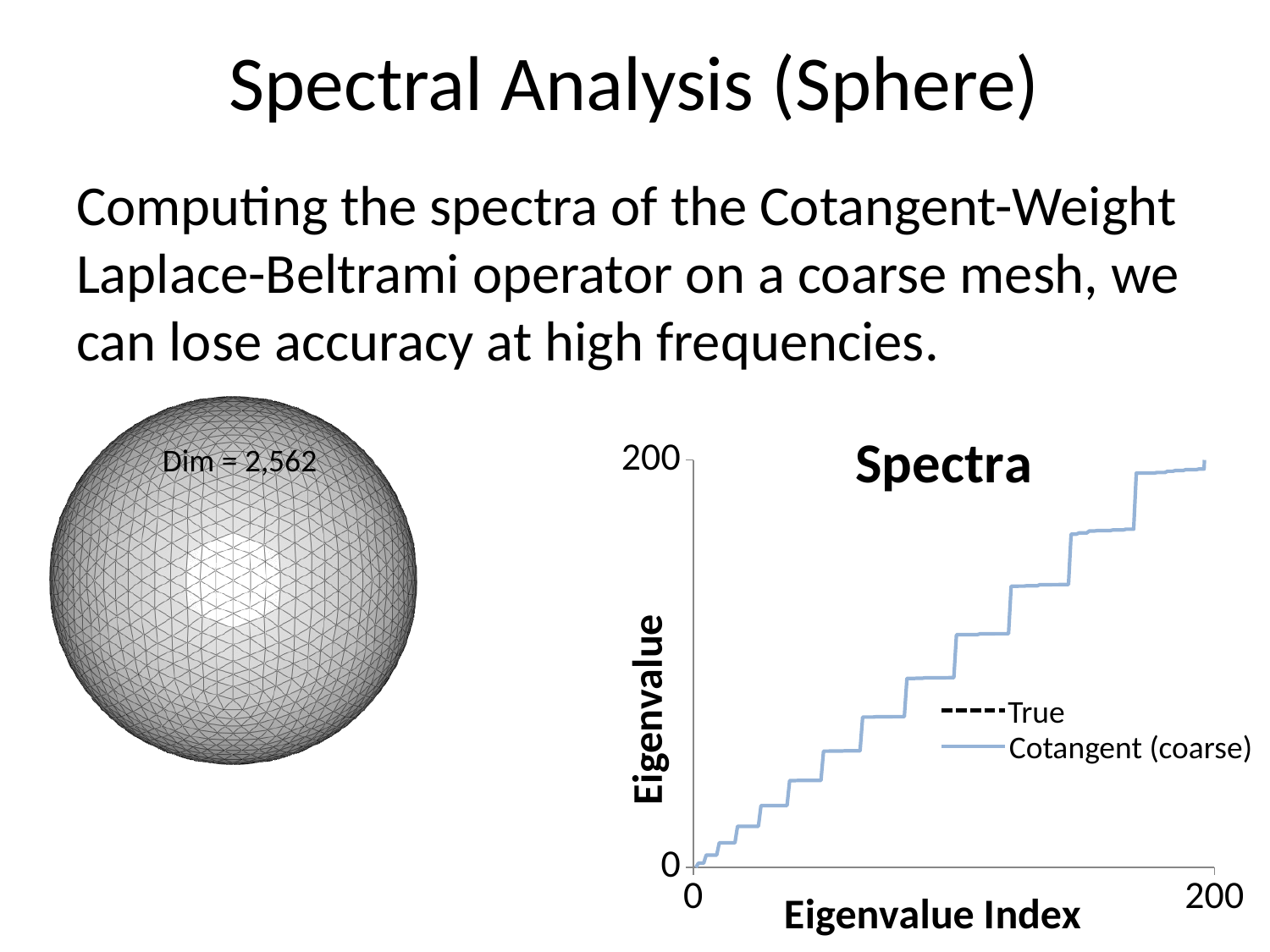
In the "Spectra" chart, do the eigenvalues rise or fall as the eigenvalue index increases? rise How many series does the legend of the "Spectra" chart list? 2 What is the label of the y axis of the "Spectra" chart? Eigenvalue What is the title of the chart on the slide? Spectra What kind of chart is the "Spectra" chart? line chart In the "Spectra" chart, is the Cotangent (coarse) eigenvalue at index 50 greater or less than 100? less In the "Spectra" chart, is the Cotangent (coarse) eigenvalue at index 150 greater or less than 100? greater In the "Spectra" chart, is the Cotangent (coarse) eigenvalue at index 200 greater or less than 100? greater What is the maximum value shown on the x axis of the "Spectra" chart? 200 What is the label of the x axis of the "Spectra" chart? Eigenvalue Index What are the two series named in the legend of the "Spectra" chart? True and Cotangent (coarse) What is the maximum value shown on the y axis of the "Spectra" chart? 200